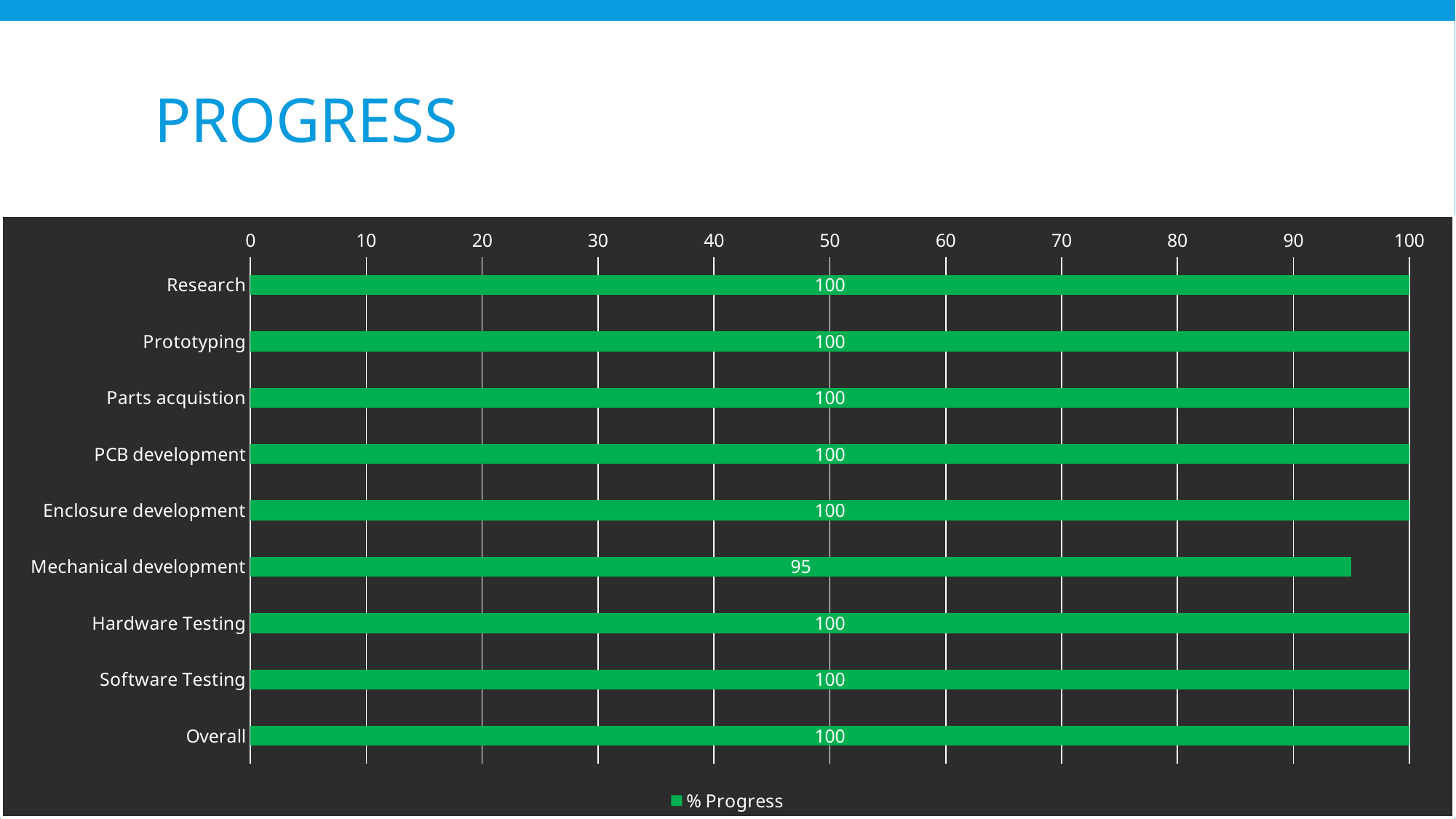
Which category has the lowest % Progress value? Mechanical development Which is larger, the % Progress value for PCB development or for Mechanical development? PCB development What is the difference between the % Progress values for Hardware Testing and Mechanical development? 5 How many categories are shown on the chart? 9 What is the % Progress value for Research? 100 What is the % Progress value for Overall? 100 What is the title of the slide? PROGRESS What is the % Progress value for Mechanical development? 95 What kind of chart is shown on the slide? bar chart What is the name of the series shown in the legend? % Progress Is the value for Mechanical development greater or less than 90? greater How many series does the legend list? 1